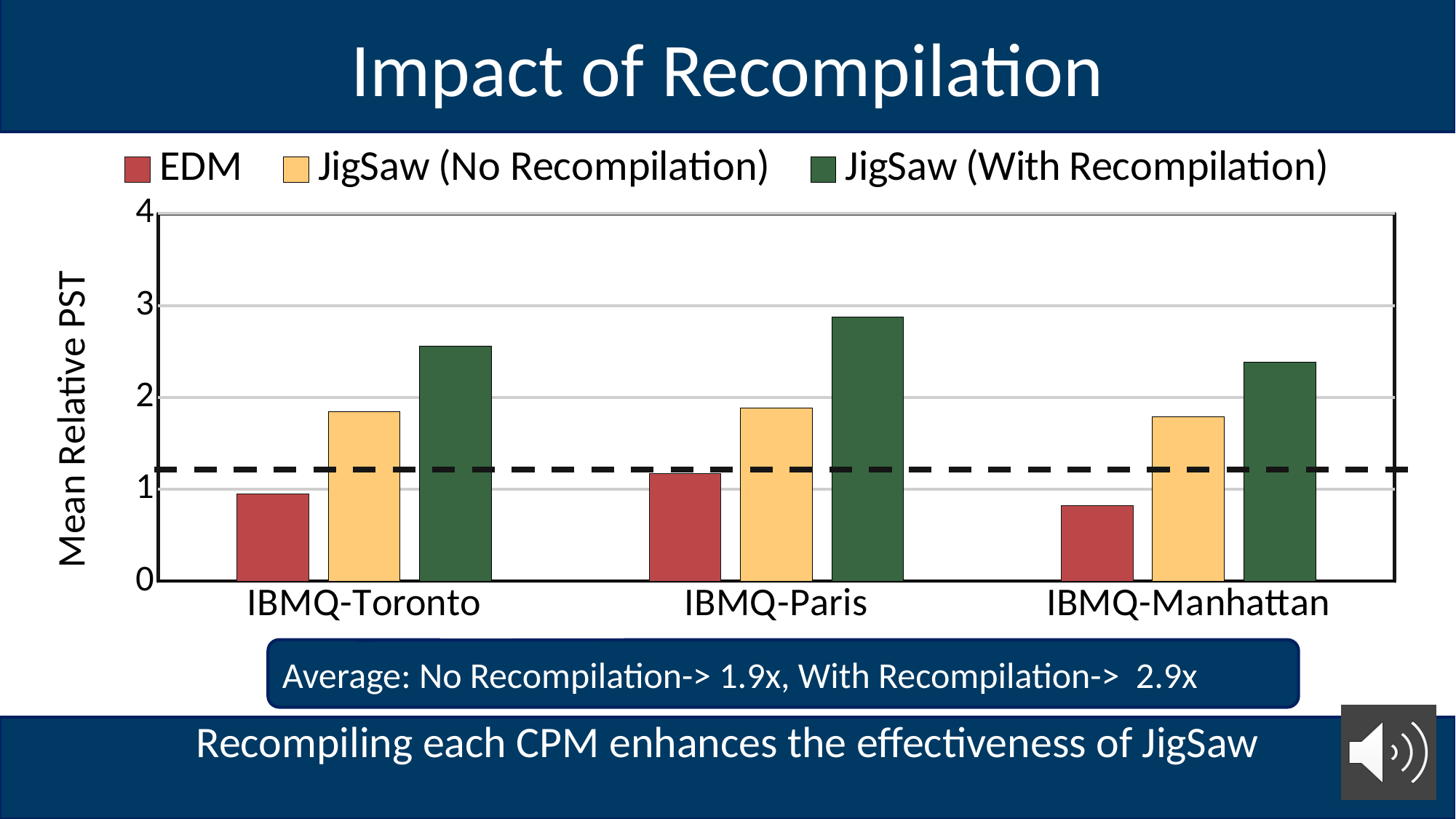
Is the EDM value for IBMQ-Manhattan greater or less than 1? less Is the JigSaw (With Recompilation) value for IBMQ-Paris greater or less than 3? less How many quantum machines (categories) are shown on the x axis? 3 Is the JigSaw (With Recompilation) value for IBMQ-Paris larger or smaller than the JigSaw (With Recompilation) value for IBMQ-Toronto? larger What is the label of the y axis? Mean Relative PST Is the JigSaw (With Recompilation) value for IBMQ-Manhattan greater or less than 2? greater Which machine has the highest JigSaw (With Recompilation) bar? IBMQ-Paris Which machine has the lowest EDM bar? IBMQ-Manhattan What kind of chart is shown on the slide? bar chart How many series does the legend list? 3